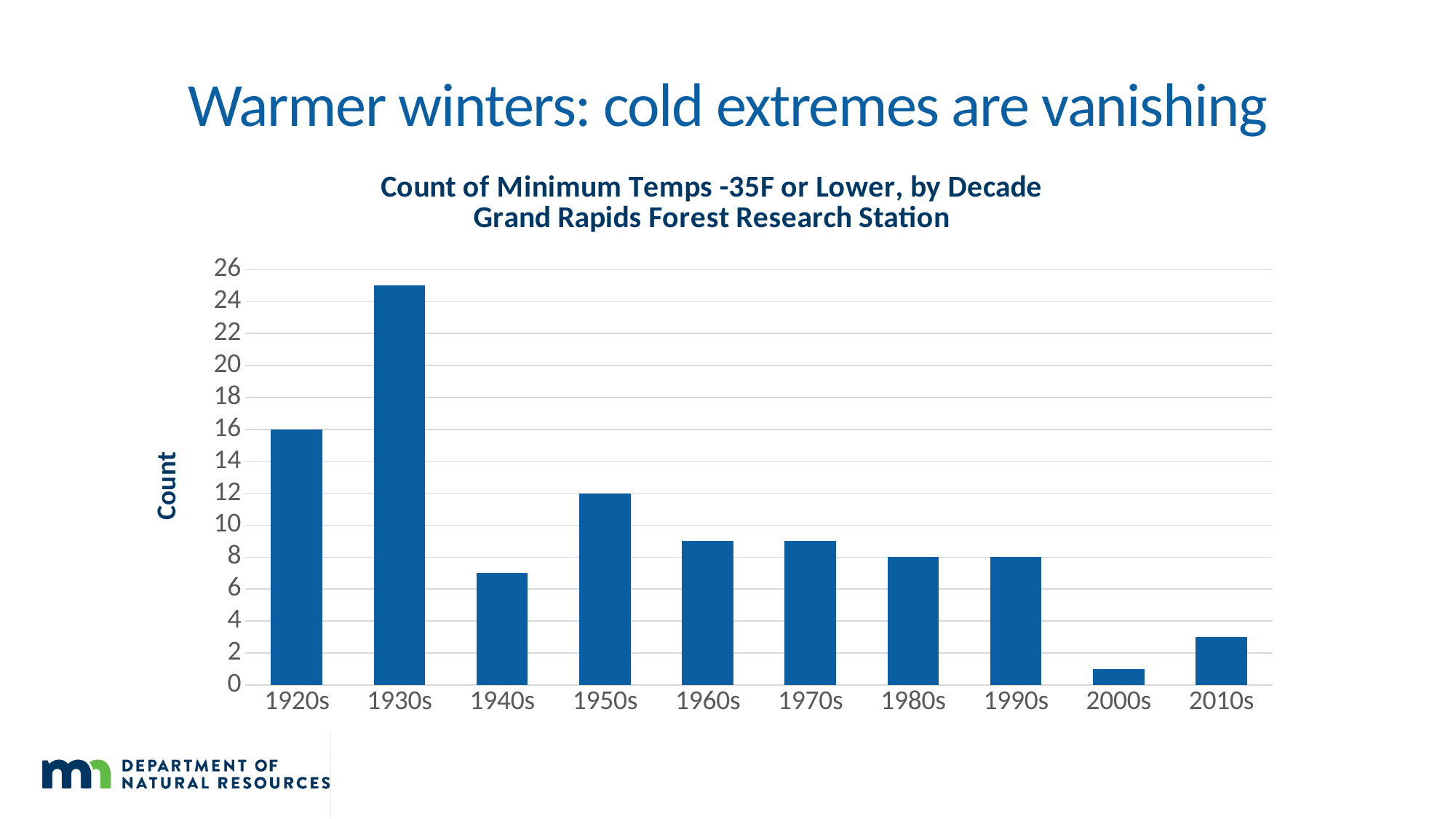
What is the label on the y axis? Count What kind of chart is shown on the slide? Bar chart What is the count for the 1980s? 8 What is the difference between the counts for the 1920s and the 1950s? 4 How many decades are shown on the x axis? 10 Which decade has the larger count, the 1950s or the 1990s? 1950s Is the value for the 1930s greater or less than 24? greater Which decade has the lowest count? 2000s Is the value for the 2000s greater or less than 2? less What is the count for the 1920s? 16 What is the count for the 1950s? 12 Which decade has the highest count? 1930s